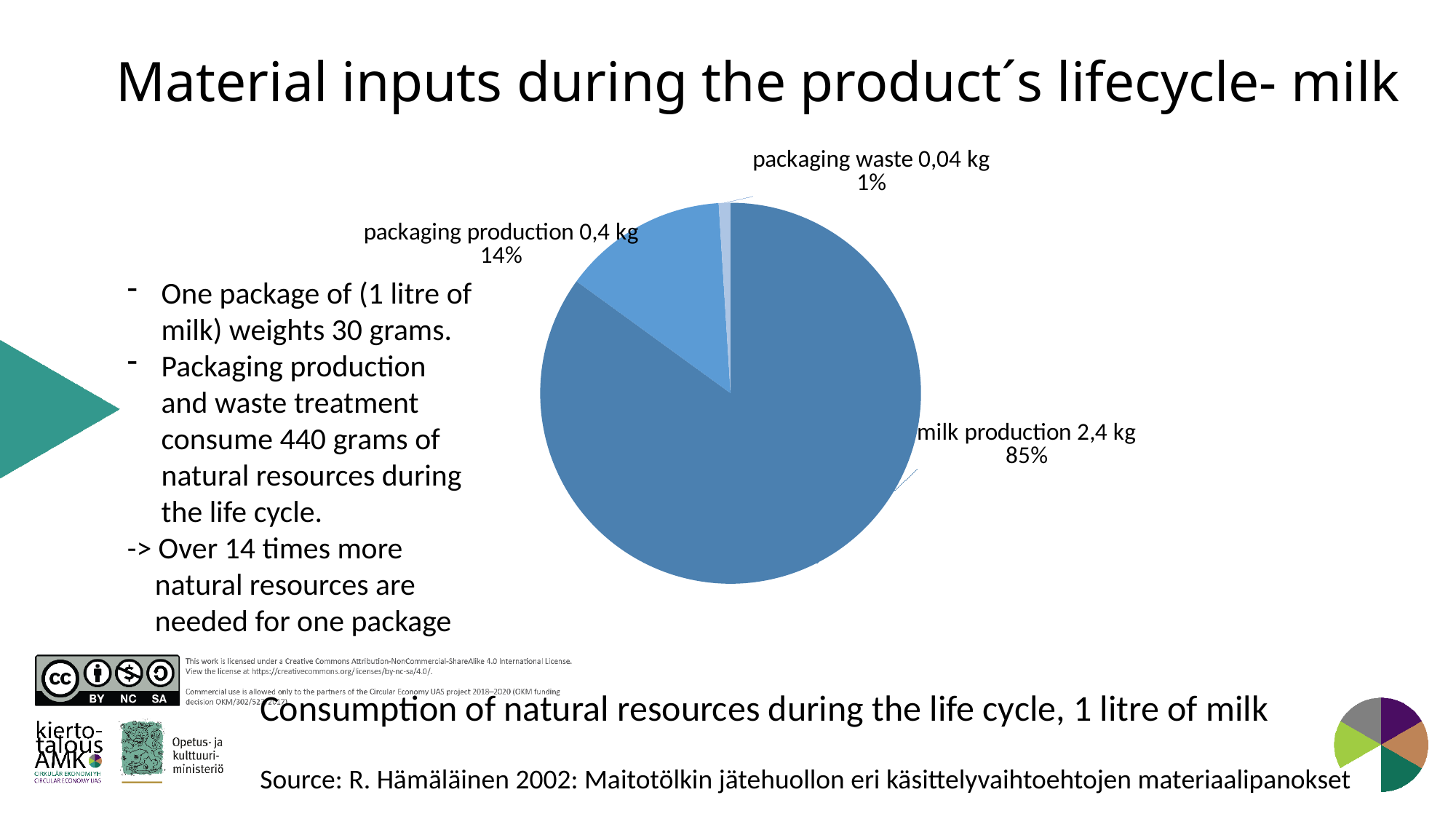
What share of the pie does packaging waste account for? 1% What is the value in kg shown for milk production? 2,4 kg Which slice of the pie is the smallest? packaging waste What share of the pie does milk production account for? 85% What share of the pie does packaging production account for? 14% What is the difference in percentage points between the milk production share and the packaging production share? 71 percentage points What is the value in kg shown for packaging production? 0,4 kg What is the value in kg shown for packaging waste? 0,04 kg What kind of chart is shown on the slide? pie chart How many slices does the pie chart have? 3 Which is larger, the share for packaging production or the share for packaging waste? packaging production Which slice of the pie is the largest? milk production